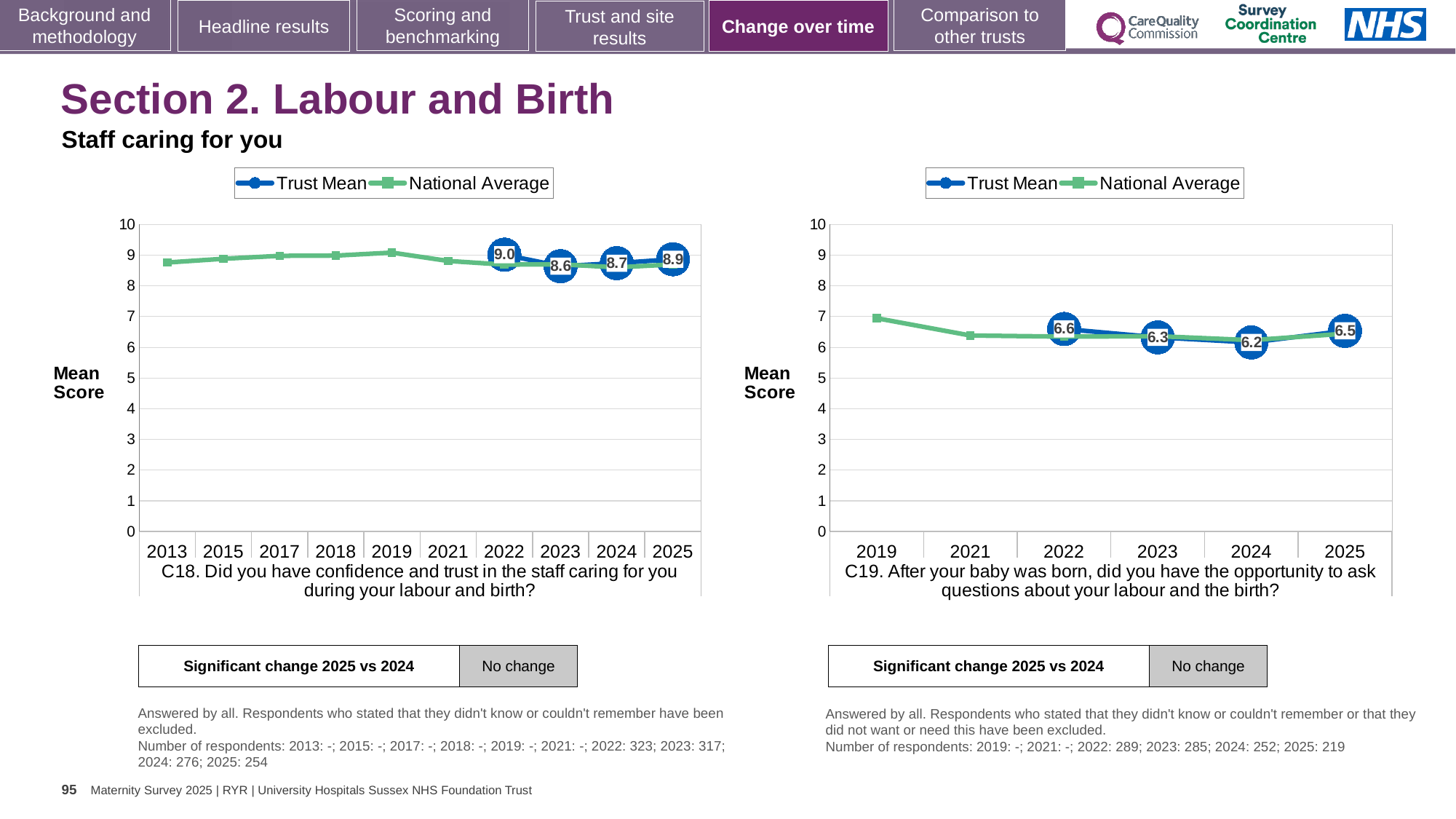
On the C18 chart (left), what is the difference between the Trust Mean for 2022 and 2023? 0.4 On the C18 chart (left), what is the Trust Mean for 2025? 8.9 On the C19 chart (right), is the National Average for 2019 greater or less than 6? greater On the C19 chart (right), which year has the lowest labelled Trust Mean? 2024 On the C18 chart (left), how many years are shown on the x axis? 10 What kind of chart is the C18 chart (left)? Line chart On the C18 chart (left), which year has the highest labelled Trust Mean? 2022 How many series does the legend of the C19 chart (right) list? 2 On the C19 chart (right), is the Trust Mean for 2022 larger or smaller than the Trust Mean for 2025? larger On the C19 chart (right), what is the Trust Mean for 2024? 6.2 On the C18 chart (left), is the National Average for 2013 greater or less than 8? greater On the C18 chart (left), what is the Trust Mean for 2023? 8.6